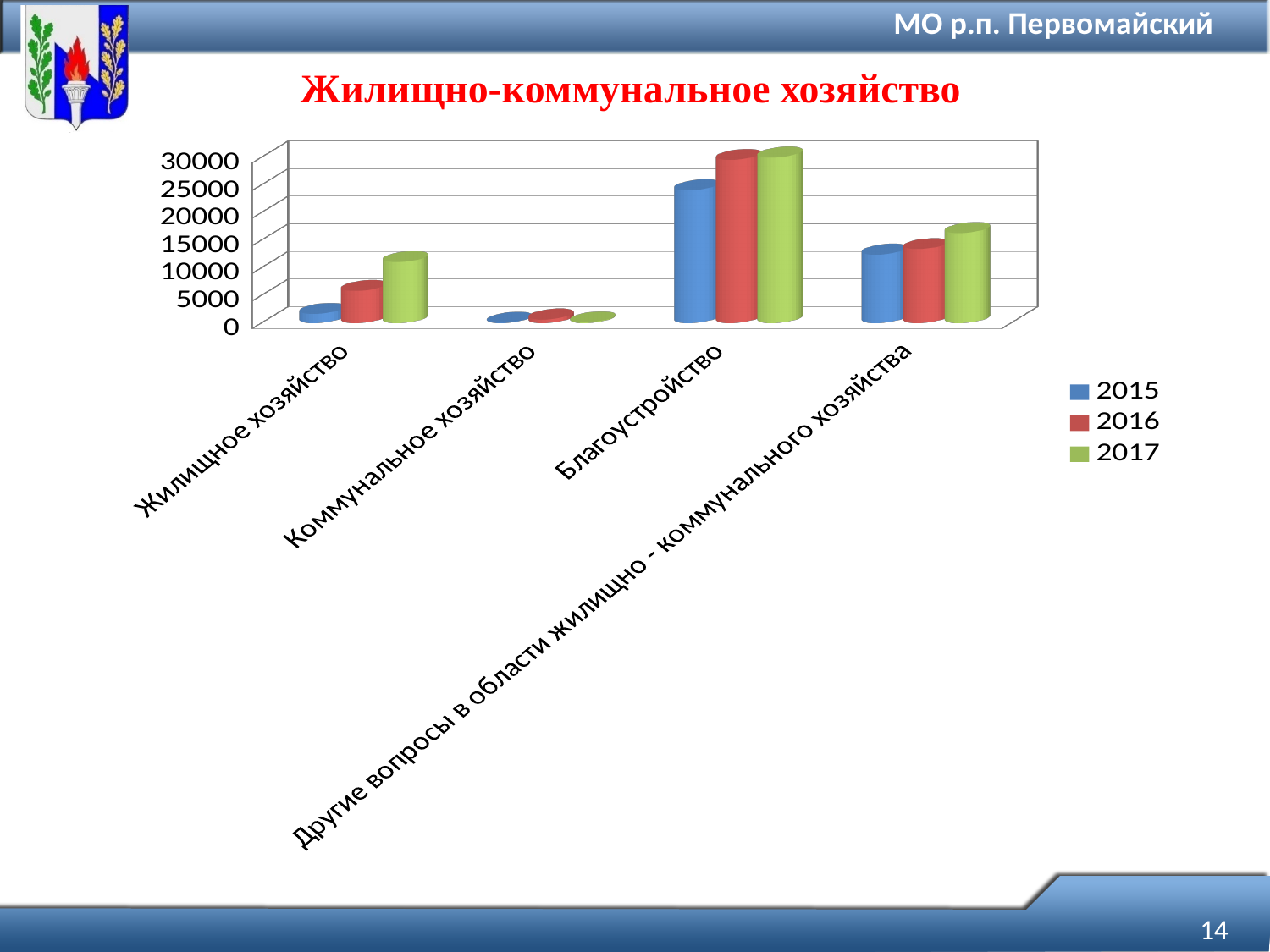
What kind of chart is shown on the slide? bar chart Is the 2017 value for Жилищное хозяйство greater or less than 15000? less Is the 2015 value for Благоустройство greater or less than 20000? greater How many categories are shown on the x axis of the chart? 4 Which category has the lowest values in the chart? Коммунальное хозяйство Is the 2015 value for Жилищное хозяйство greater or less than 5000? less Which is larger for Жилищное хозяйство: the 2015 value or the 2017 value? 2017 Do the values for Жилищное хозяйство rise or fall from 2015 to 2017? rise How many series does the chart legend list? 3 Which category has the highest values in the chart? Благоустройство Which is larger for Благоустройство: the 2015 value or the 2016 value? 2016 What is the title of the chart on the slide? Жилищно-коммунальное хозяйство